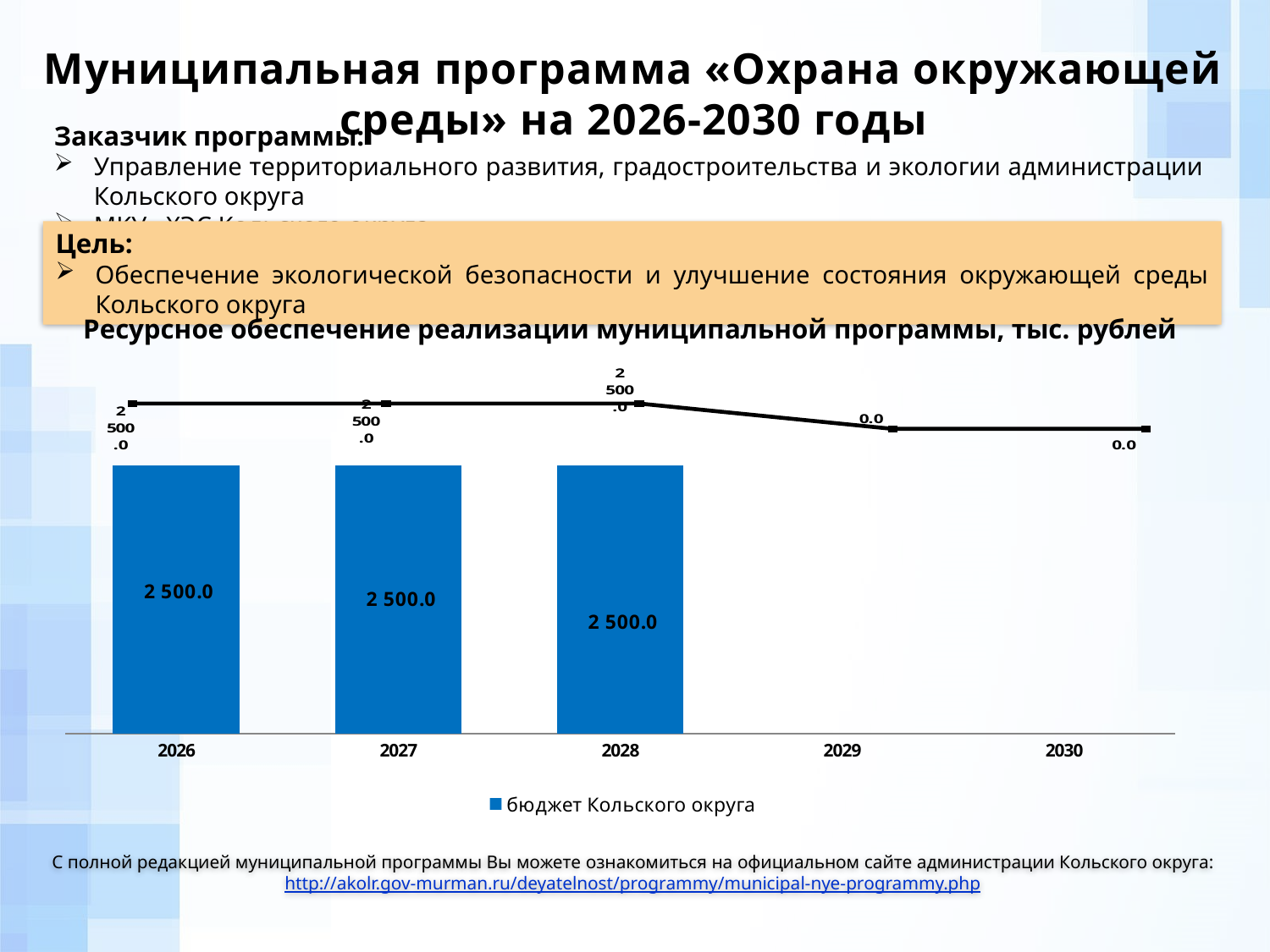
What is the title of the chart? Ресурсное обеспечение реализации муниципальной программы, тыс. рублей Which is larger, the value for 2027 or the value for 2029? 2027 What kind of chart is shown on the slide? bar chart with a line Do the values rise or fall from 2028 to 2029? fall What is the name of the series listed in the legend? бюджет Кольского округа What value is labelled on the line for 2029? 0.0 What value is labelled on the line for 2030? 0.0 How many years are shown on the x axis of the chart? 5 How many series does the chart legend list? 1 What is the value of the bar for 2026? 2 500.0 What is the difference between the value for 2026 and the value for 2029? 2 500.0 What is the value of the bar for 2028? 2 500.0